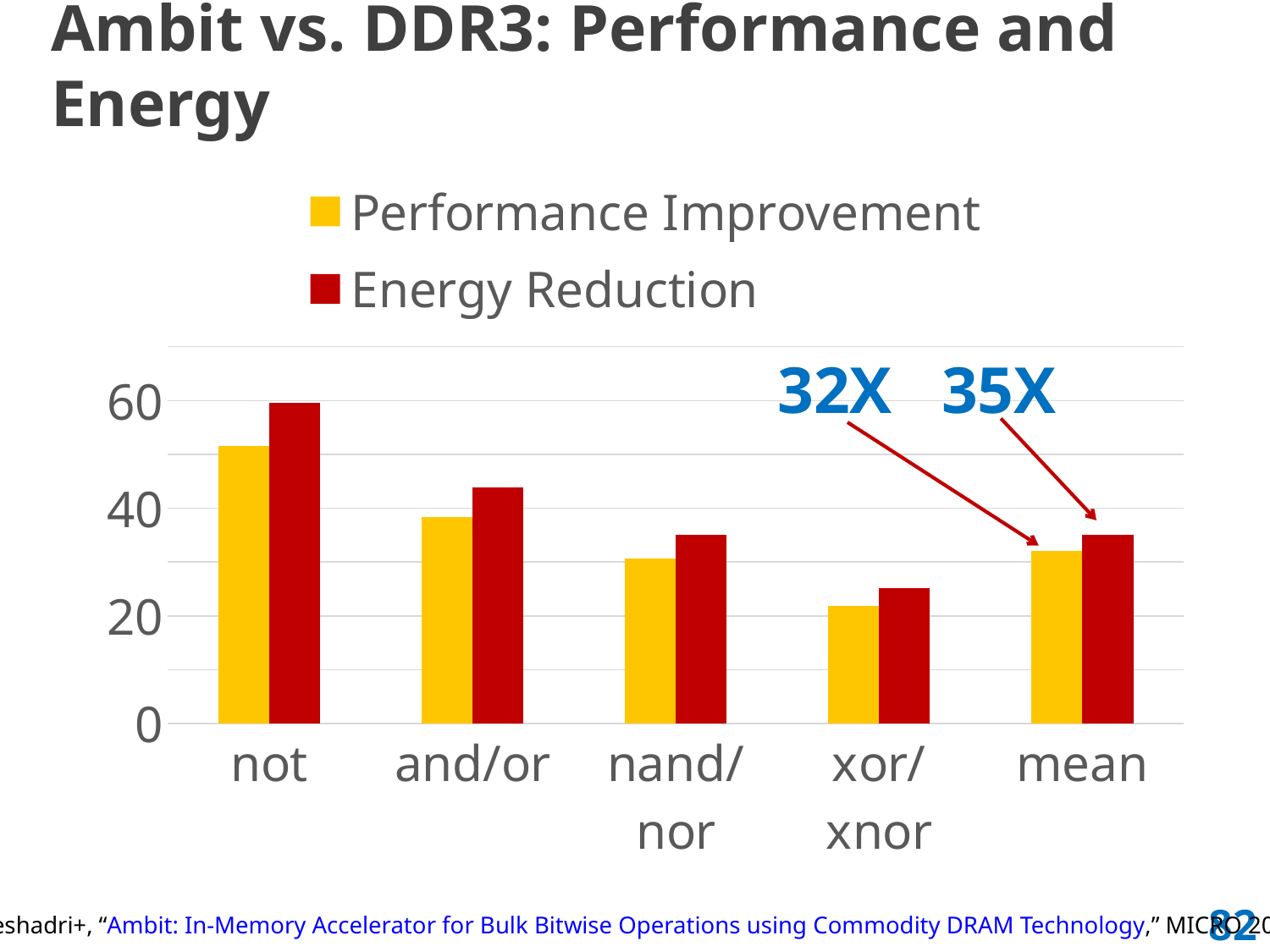
For the not category, which is larger: Performance Improvement or Energy Reduction? Energy Reduction Is the Energy Reduction value for xor/xnor greater or less than 20? greater Do the Performance Improvement values rise or fall from not to xor/xnor along the x axis? fall How many series does the legend list? 2 How many categories are shown on the x axis? 5 What is the annotated Performance Improvement value for the mean category? 32X What kind of chart is shown on the slide? bar chart Which category has the highest Energy Reduction? not What is the annotated Energy Reduction value for the mean category? 35X Is the Performance Improvement value for and/or greater or less than 40? less Which colour represents Energy Reduction in the legend? red Which category has the lowest Performance Improvement? xor/xnor